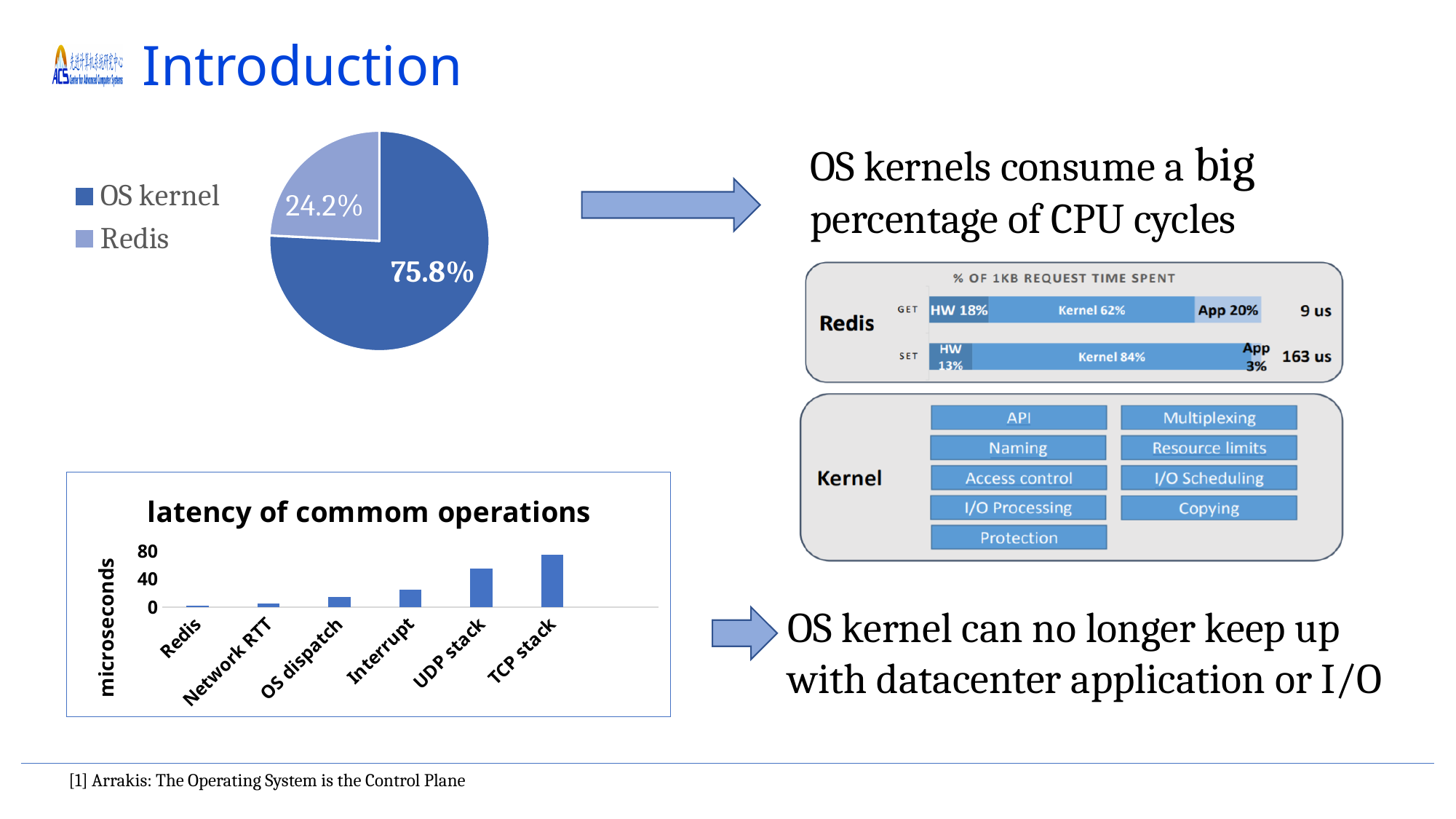
In the pie chart, what is the value shown for Redis? 24.2% What kind of chart is the 'latency of commom operations' chart? bar chart How many categories are shown in the 'latency of commom operations' chart? 6 In the pie chart, what is the difference between the OS kernel share and the Redis share? 51.6% In the pie chart, which slice is larger, OS kernel or Redis? OS kernel What is the title of the bar chart at the bottom left of the slide? latency of commom operations In the 'latency of commom operations' chart, which category has the lowest value? Redis In the 'latency of commom operations' chart, is the value for UDP stack greater or less than 40? greater In the 'latency of commom operations' chart, which category has the highest value? TCP stack How many entries does the legend of the pie chart list? 2 In the pie chart, what share of the pie does OS kernel take? 75.8% In the 'latency of commom operations' chart, do the values rise or fall from left to right along the x axis? rise